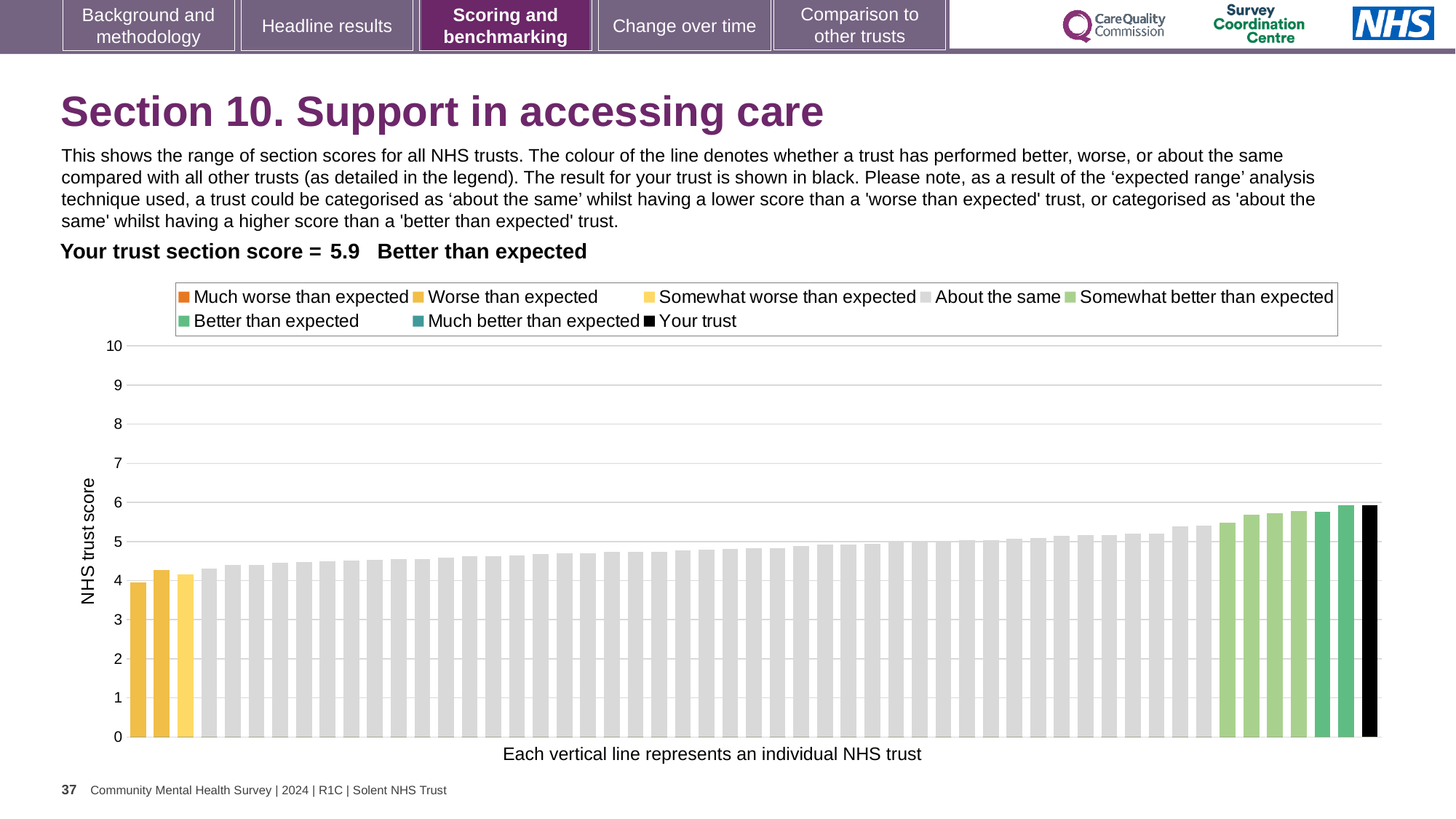
What type of chart is shown on the slide? bar chart What is the section score for your trust shown on the slide? 5.9 Is the value of the black 'Your trust' bar greater or less than 5? greater Do the bar values rise or fall from left to right along the x axis? rise Is the value of the leftmost bar greater or less than 3? greater Which performance category is your trust placed in for this section? Better than expected What colour is used for the bar representing your trust? black What is the title of the vertical axis? NHS trust score How many entries does the chart legend list? 8 Which is larger, the leftmost bar or the rightmost (black) bar? the rightmost (black) bar Is the value of the highest bar greater or less than 7? less